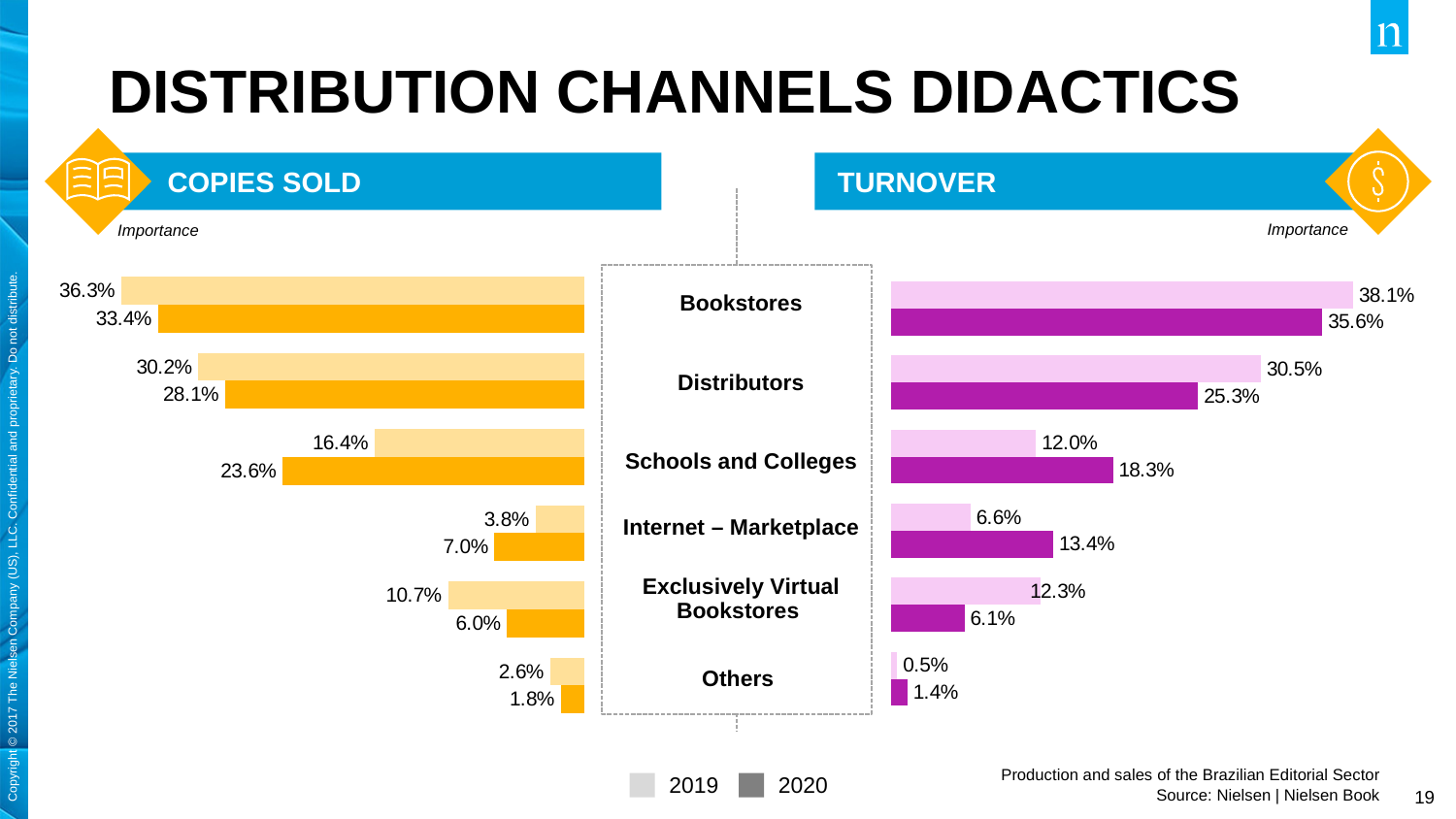
In the COPIES SOLD chart, what is the value for Exclusively Virtual Bookstores in 2020? 6.0% What kind of chart is the TURNOVER chart? Bar chart In the COPIES SOLD chart, what is the difference between the 2020 and 2019 values for Schools and Colleges? 7.2% In the TURNOVER chart, which is larger for Distributors: the 2019 value or the 2020 value? 2019 In the COPIES SOLD chart, what is the value for Bookstores in 2019? 36.3% In the TURNOVER chart, what is the difference between the 2019 and 2020 values for Internet – Marketplace? 6.8% How many categories are shown in the COPIES SOLD chart? 6 In the TURNOVER chart, which category has the highest value in 2019? Bookstores In the TURNOVER chart, what is the value for Schools and Colleges in 2020? 18.3% In the COPIES SOLD chart, which category has the lowest value in 2020? Others What are the two series named in the legend? 2019 and 2020 How many series does the legend list? 2